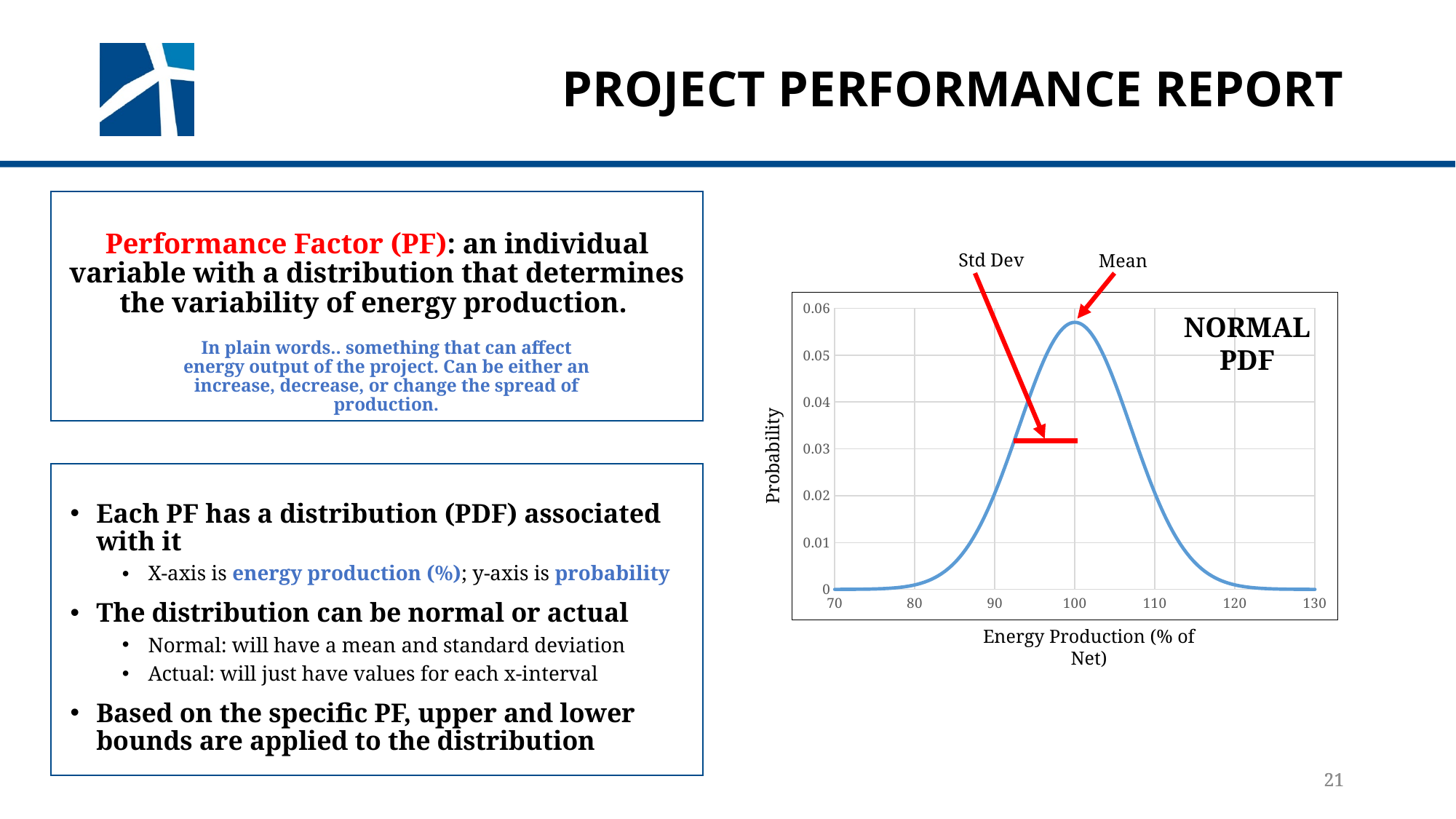
At which x-axis value does the NORMAL PDF curve reach its peak? 100 What is the x-axis title of the NORMAL PDF chart? Energy Production (% of Net) What is the highest value labelled on the y-axis of the NORMAL PDF chart? 0.06 In the NORMAL PDF chart, is the probability higher at an energy production of 100 or at 120? 100 What kind of chart is shown on the right side of the slide? line chart In the NORMAL PDF chart, does the curve rise or fall as energy production increases from 100 to 130? fall In the NORMAL PDF chart, is the probability at an energy production of 80 greater or less than 0.01? less In the NORMAL PDF chart, does the curve rise or fall as energy production increases from 70 to 100? rise What is the title of the chart on the right side of the slide? NORMAL PDF In the NORMAL PDF chart, is the probability at an energy production of 90 greater or less than 0.03? less In the NORMAL PDF chart, is the probability at an energy production of 100 greater or less than 0.05? greater